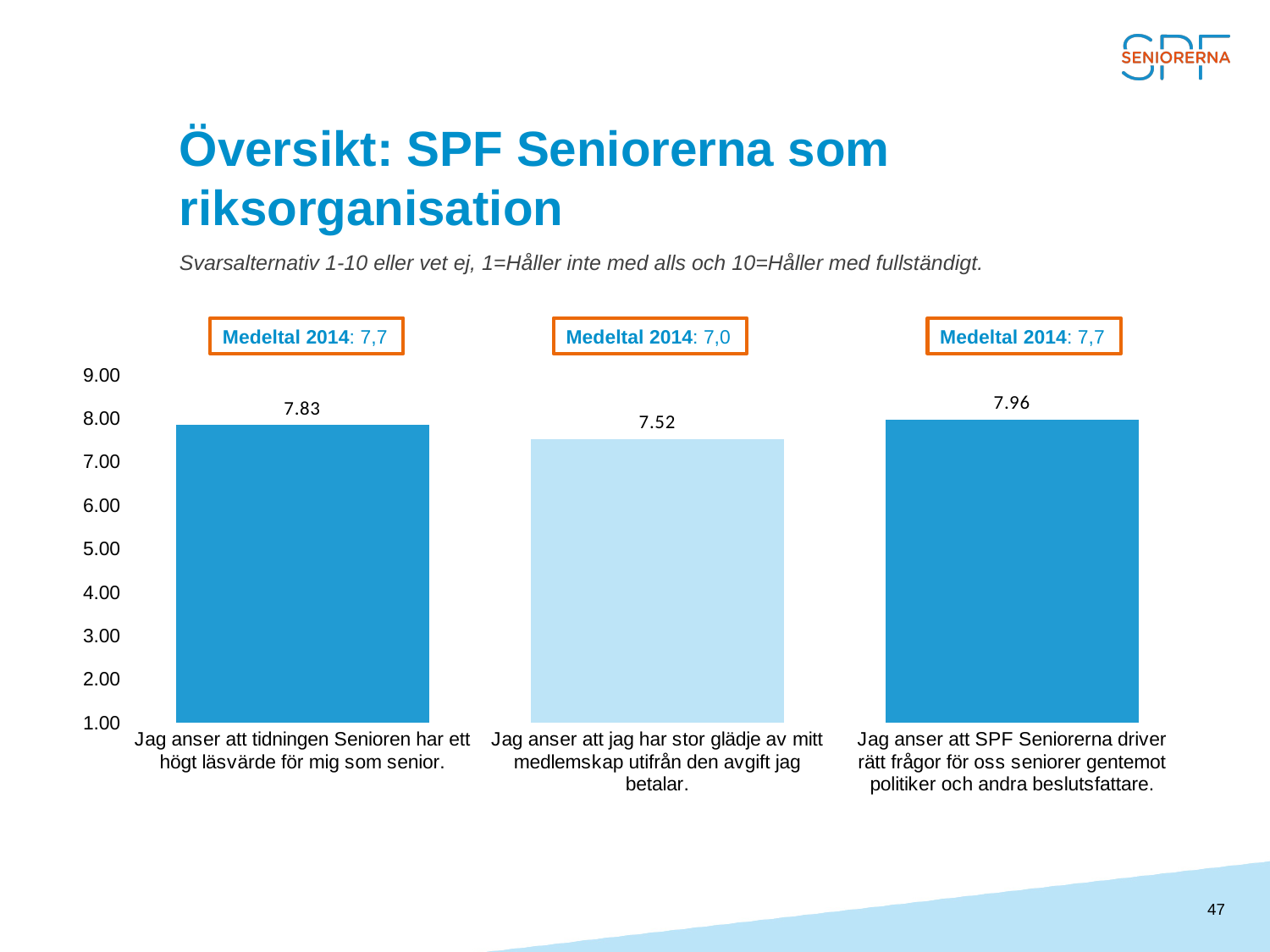
What is the value for "Jag anser att SPF Seniorerna driver rätt frågor för oss seniorer gentemot politiker och andra beslutsfattare."? 7.96 What kind of chart is shown on the slide? bar chart What is the "Medeltal 2014" value shown above the middle bar? 7,0 What is the difference between the value for "Jag anser att SPF Seniorerna driver rätt frågor..." and the value for "Jag anser att jag har stor glädje av mitt medlemskap..."? 0.44 Which category has the lowest value? Jag anser att jag har stor glädje av mitt medlemskap utifrån den avgift jag betalar. What is the value for "Jag anser att jag har stor glädje av mitt medlemskap utifrån den avgift jag betalar."? 7.52 Which is larger: the value for "Jag anser att tidningen Senioren har ett högt läsvärde..." or the value for "Jag anser att jag har stor glädje av mitt medlemskap..."? Jag anser att tidningen Senioren har ett högt läsvärde för mig som senior. What is the value for "Jag anser att tidningen Senioren har ett högt läsvärde för mig som senior."? 7.83 Is the value for "Jag anser att jag har stor glädje av mitt medlemskap..." greater or less than 8.00? less What is the difference between the value for "Jag anser att tidningen Senioren har ett högt läsvärde..." and the value for "Jag anser att jag har stor glädje av mitt medlemskap..."? 0.31 Which category has the highest value? Jag anser att SPF Seniorerna driver rätt frågor för oss seniorer gentemot politiker och andra beslutsfattare. How many categories are shown in the chart? 3